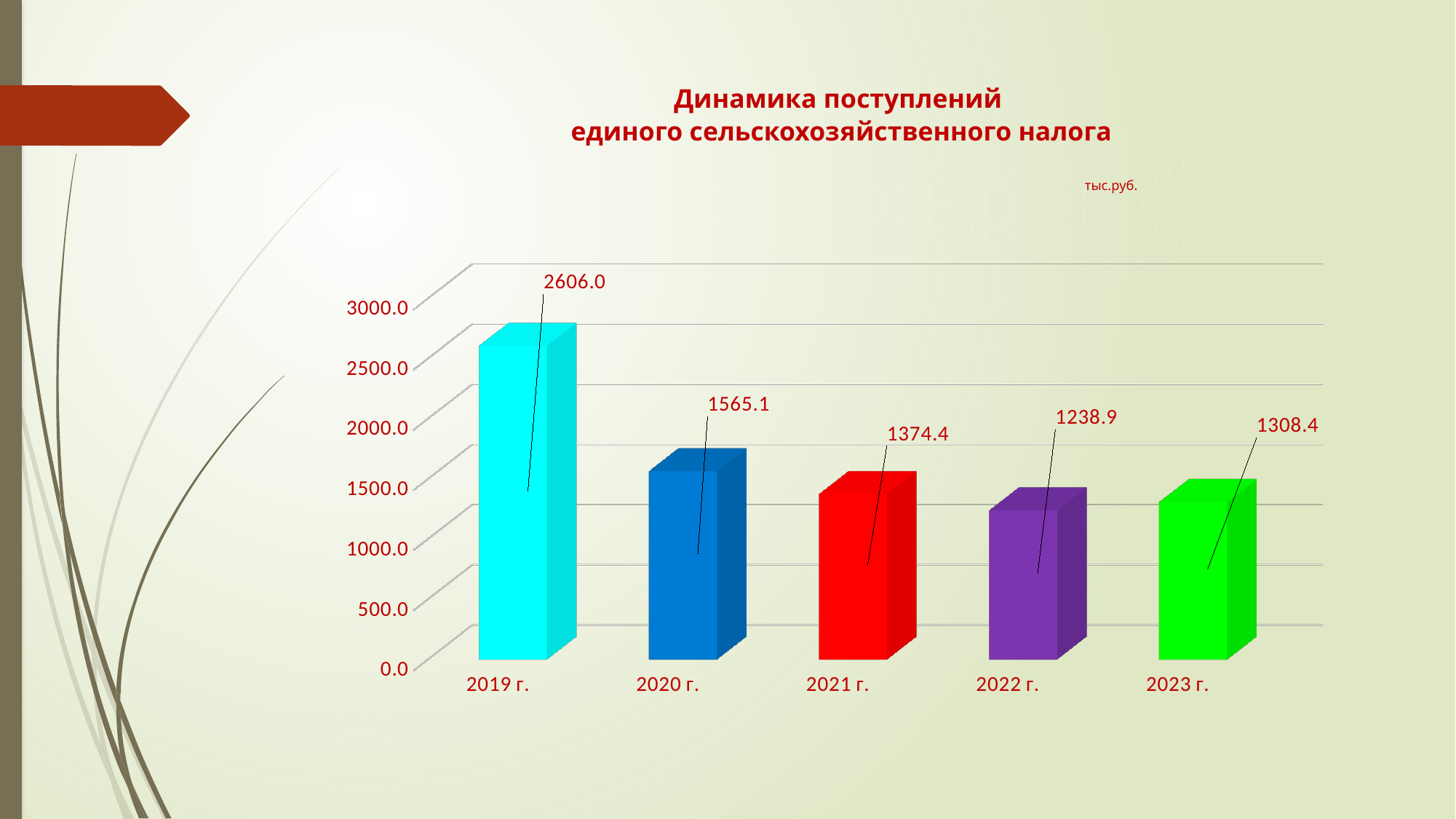
What is the difference between the values for 2023 г. and 2022 г.? 69.5 What kind of chart is shown on the slide? bar chart Is the value for 2022 г. greater or less than 1500.0? less What is the value for 2021 г.? 1374.4 What is the value for 2019 г.? 2606.0 How many years are shown on the chart? 5 Which is larger, the value for 2020 г. or the value for 2021 г.? 2020 г. What is the difference between the values for 2019 г. and 2020 г.? 1040.9 What unit is indicated above the chart? тыс.руб. Which year has the highest value? 2019 г. What is the value for 2023 г.? 1308.4 Which year has the lowest value? 2022 г.